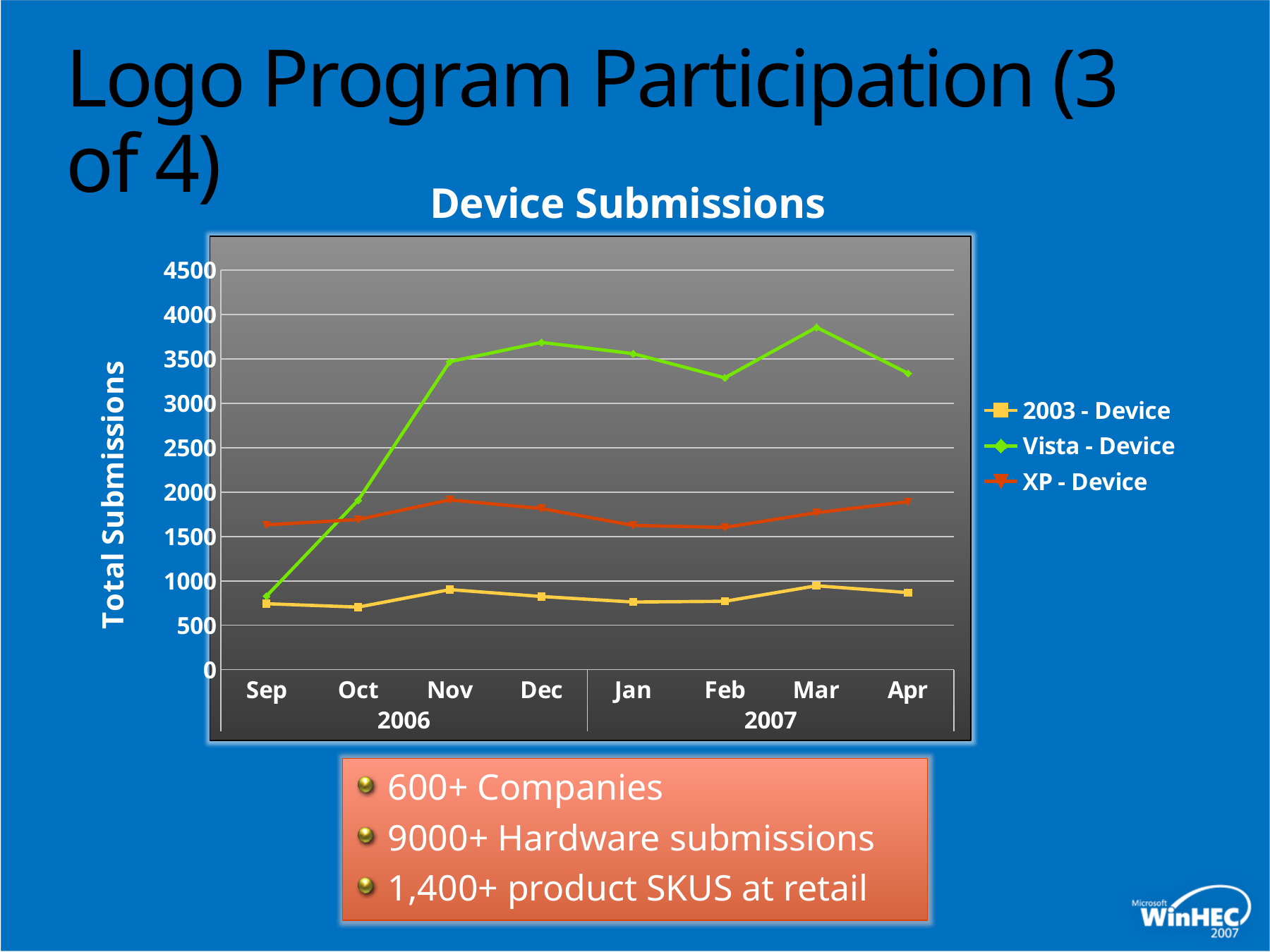
What kind of chart is shown on the slide? line chart Is the value for XP - Device in Sep greater or less than 2000? less In which month does the Vista - Device series reach its highest value? Mar In Dec, which series has the larger value, Vista - Device or XP - Device? Vista - Device Is the value for 2003 - Device in Mar greater or less than 1000? less How many series does the legend list? 3 Is the value for Vista - Device in Sep greater or less than 1000? less How many months are plotted along the x axis? 8 Does the Vista - Device series rise or fall from Sep to Nov? rise In which month is the Vista - Device series at its lowest value? Sep What is the title of the chart? Device Submissions